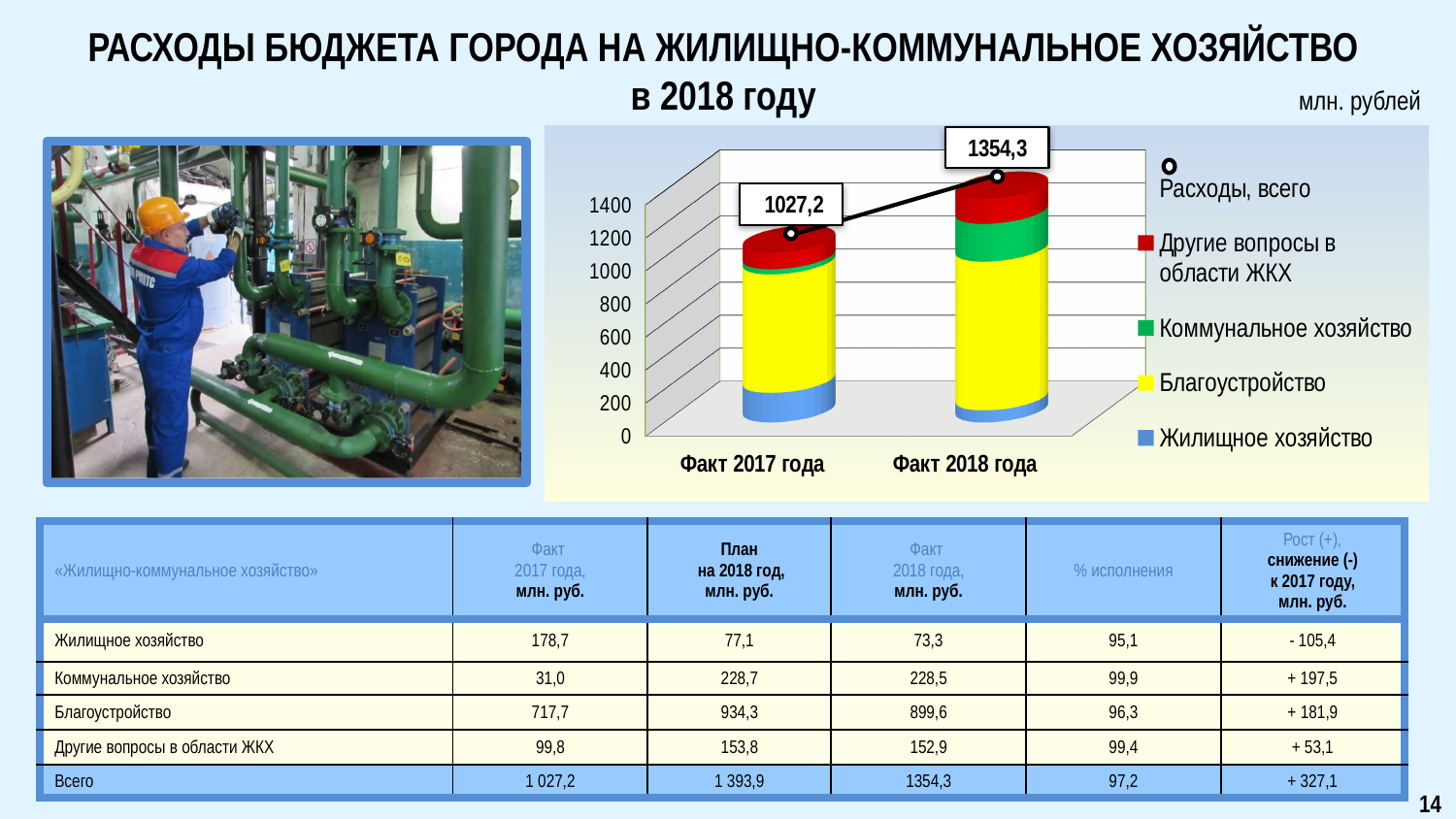
How many entries does the chart legend list? 5 What is the value of Расходы, всего for Факт 2018 года? 1354,3 Which is larger for Расходы, всего: Факт 2017 года or Факт 2018 года? Факт 2018 года What colour represents Благоустройство in the chart legend? Yellow In what units are the chart values given? млн. рублей Which category has the highest total expenditure (Расходы, всего)? Факт 2018 года Does Расходы, всего rise or fall from Факт 2017 года to Факт 2018 года? Rise What is the value of Расходы, всего for Факт 2017 года? 1027,2 What kind of chart is shown on the slide? Stacked bar chart with a line How many categories are shown on the x axis of the chart? 2 By how much does Расходы, всего for Факт 2018 года exceed Факт 2017 года? 327,1 Is the value of Расходы, всего for Факт 2017 года greater or less than 1000? greater